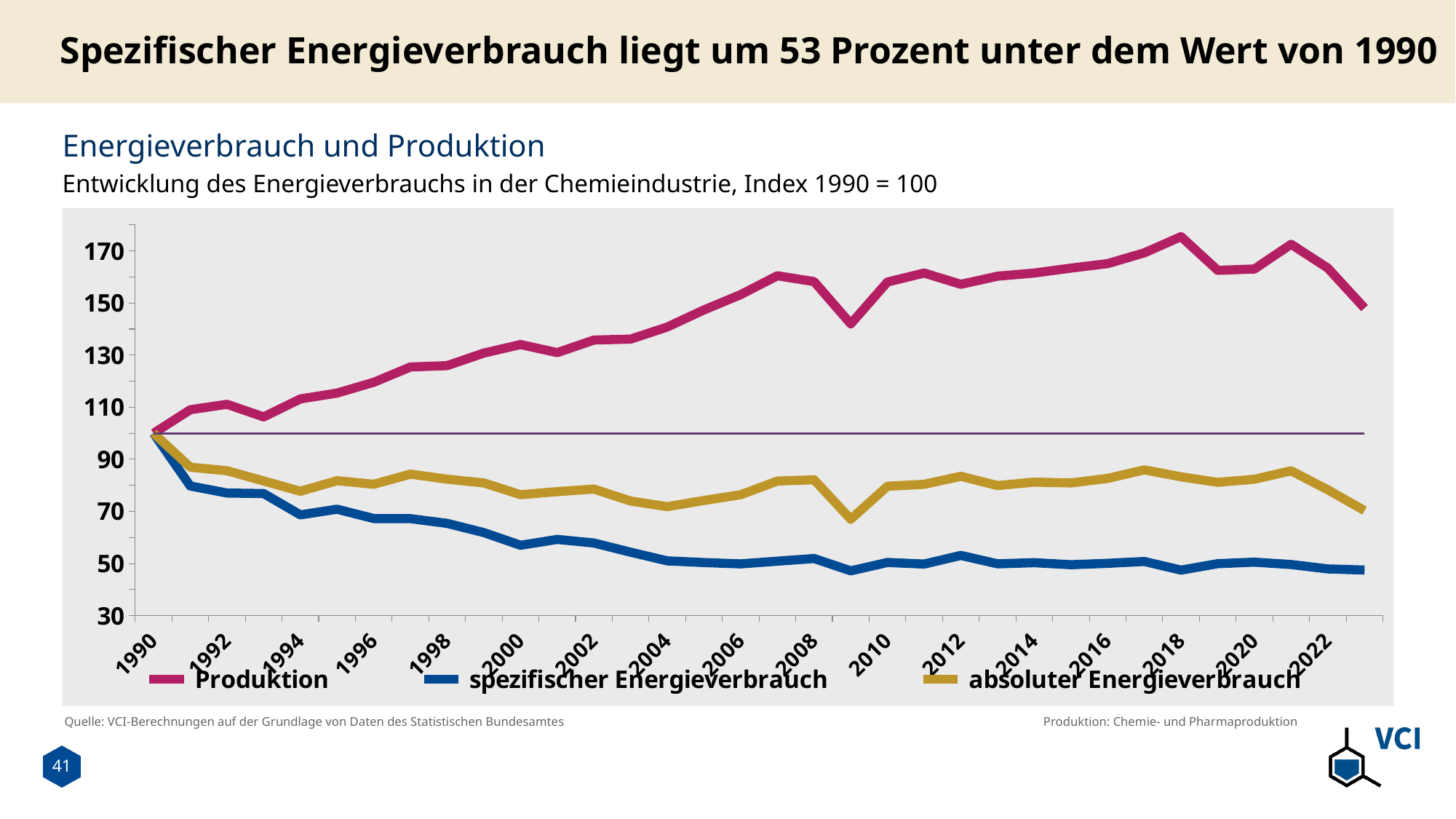
Is the value for absoluter Energieverbrauch in 2009 greater or less than 70? less What kind of chart is shown on the slide? line chart In 2010, which is larger: absoluter Energieverbrauch or spezifischer Energieverbrauch? absoluter Energieverbrauch Does the spezifischer Energieverbrauch series generally rise or fall from 1990 to 2022? fall What is the index value of all three series in 1990? 100 How many series does the legend list? 3 Does the Produktion series generally rise or fall from 1990 to 2022? rise What is the title of the chart? Energieverbrauch und Produktion Is the value for spezifischer Energieverbrauch in 2000 greater or less than 70? less Which series has the highest value in 2022? Produktion Is the value for Produktion in 2018 greater or less than 170? greater